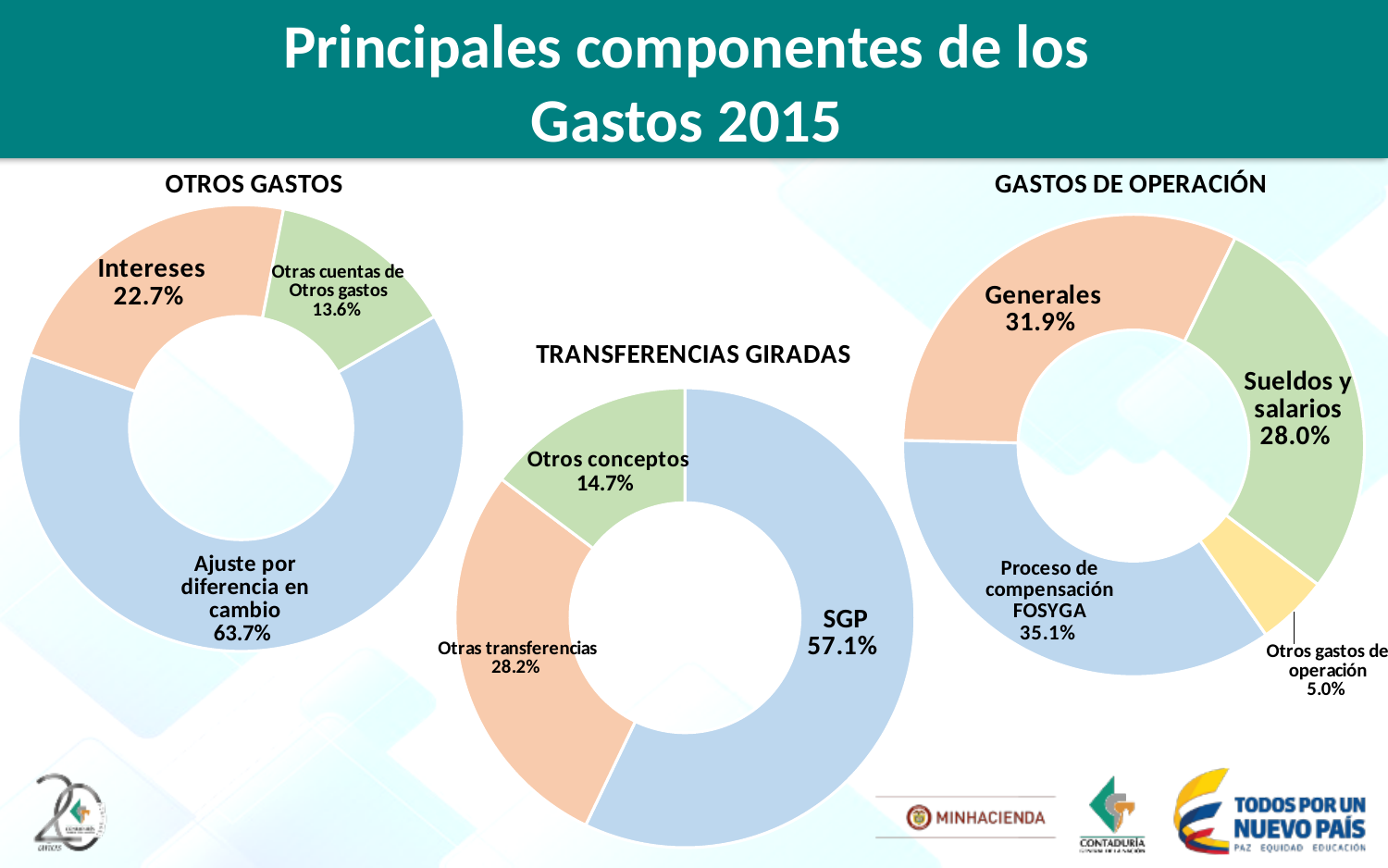
In the OTROS GASTOS chart, what is the share for Ajuste por diferencia en cambio? 63.7% In the GASTOS DE OPERACIÓN chart, what is the difference between Proceso de compensación FOSYGA and Generales? 3.2% In the GASTOS DE OPERACIÓN chart, which category has the largest share? Proceso de compensación FOSYGA What kind of chart is the OTROS GASTOS chart? Doughnut chart In the TRANSFERENCIAS GIRADAS chart, what is the share for SGP? 57.1% How many categories does the GASTOS DE OPERACIÓN chart show? 4 In the TRANSFERENCIAS GIRADAS chart, which is larger, Otras transferencias or Otros conceptos? Otras transferencias In the OTROS GASTOS chart, what is the difference between the shares of Intereses and Otras cuentas de Otros gastos? 9.1% In the OTROS GASTOS chart, which category has the smallest share? Otras cuentas de Otros gastos In the GASTOS DE OPERACIÓN chart, what is the share for Sueldos y salarios? 28.0% How many charts are shown on the slide? 3 How many categories does the TRANSFERENCIAS GIRADAS chart show? 3